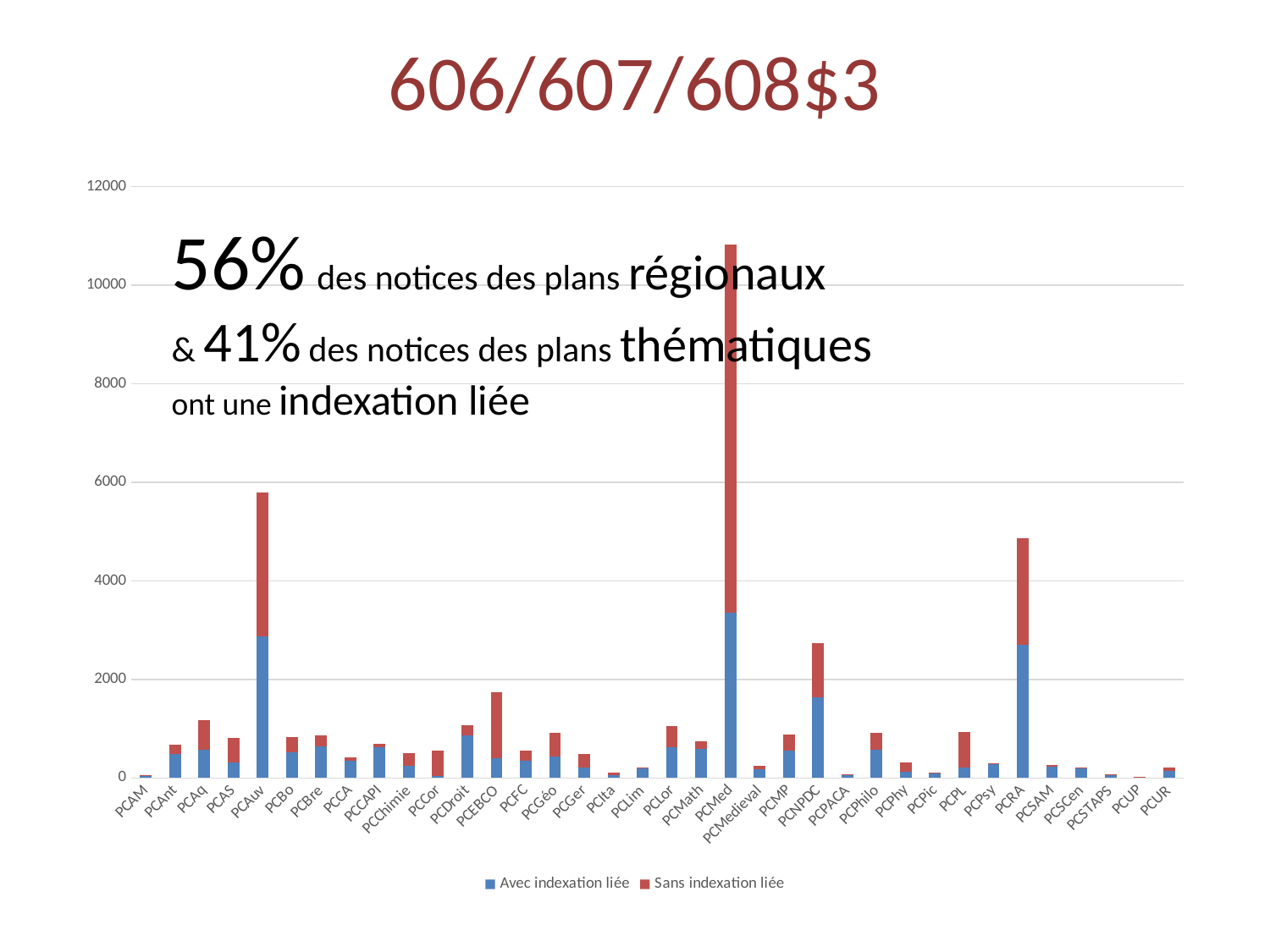
Which category has the tallest stacked bar? PCMed Is the total stacked value for PCNPDC greater or less than 2000? greater Is the total stacked value for PCMed greater or less than 10000? greater What colour represents the series 'Sans indexation liée'? red Is the total stacked value for PCAuv greater or less than 6000? less What kind of chart is shown on the slide? stacked bar chart How many categories are shown on the x axis? 36 What are the two series named in the legend? Avec indexation liée; Sans indexation liée Which has the taller stacked bar, PCAuv or PCRA? PCAuv How many series does the legend list? 2 Which has the taller stacked bar, PCEBCO or PCNPDC? PCNPDC